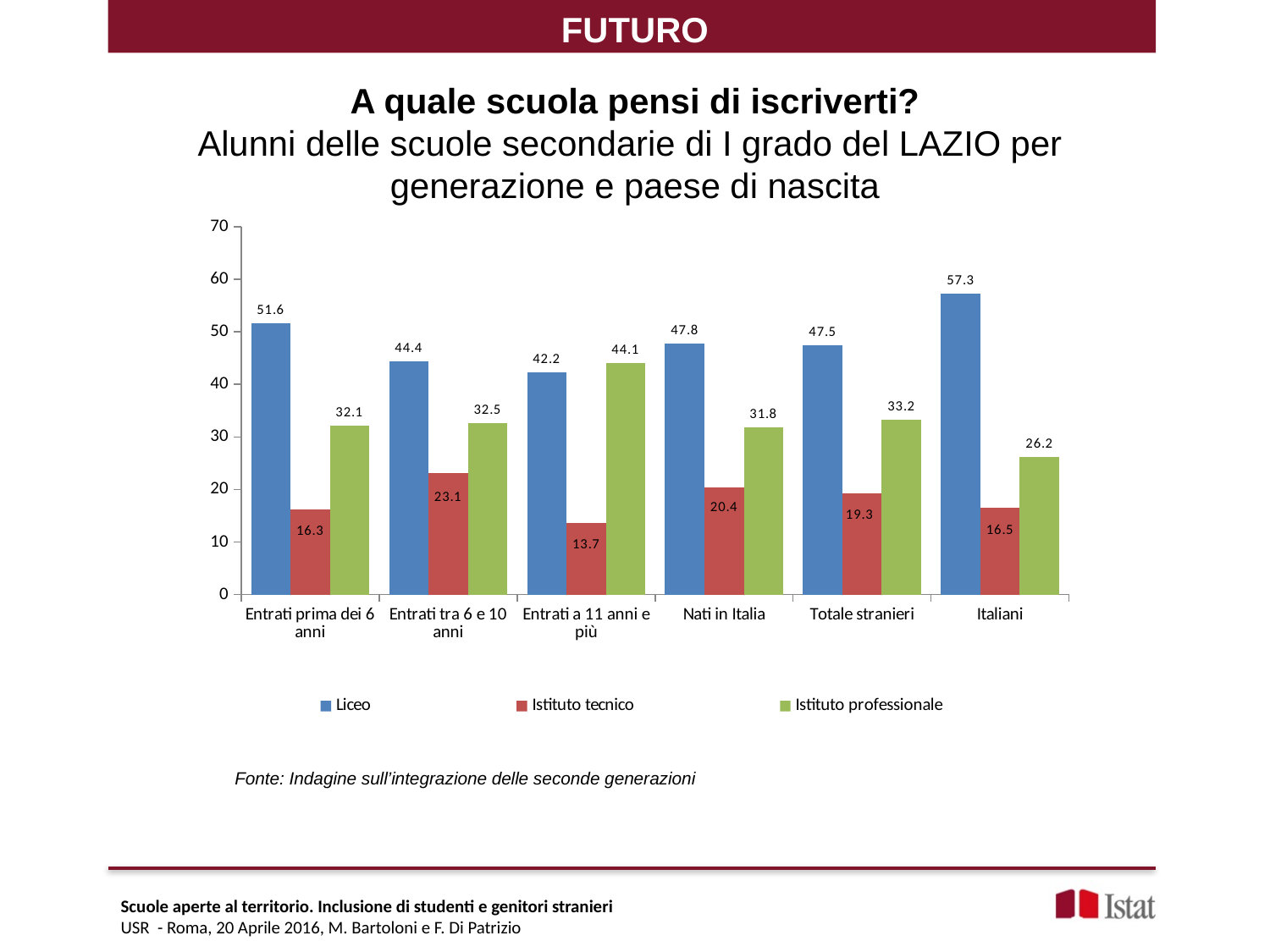
Which category has the highest Liceo value? Italiani For Entrati a 11 anni e più, which is larger: the Liceo value or the Istituto professionale value? Istituto professionale Which series is shown in green in the legend? Istituto professionale What is the Liceo value for Italiani? 57.3 What is the Istituto tecnico value for Entrati tra 6 e 10 anni? 23.1 Is the Istituto professionale value for Nati in Italia greater or less than 30? greater How many series does the legend list? 3 What kind of chart is shown on the slide? bar chart How many categories are shown on the x axis? 6 What is the Istituto professionale value for Entrati a 11 anni e più? 44.1 Which category has the lowest Istituto tecnico value? Entrati a 11 anni e più What is the difference between the Liceo value for Italiani and the Liceo value for Totale stranieri? 9.8